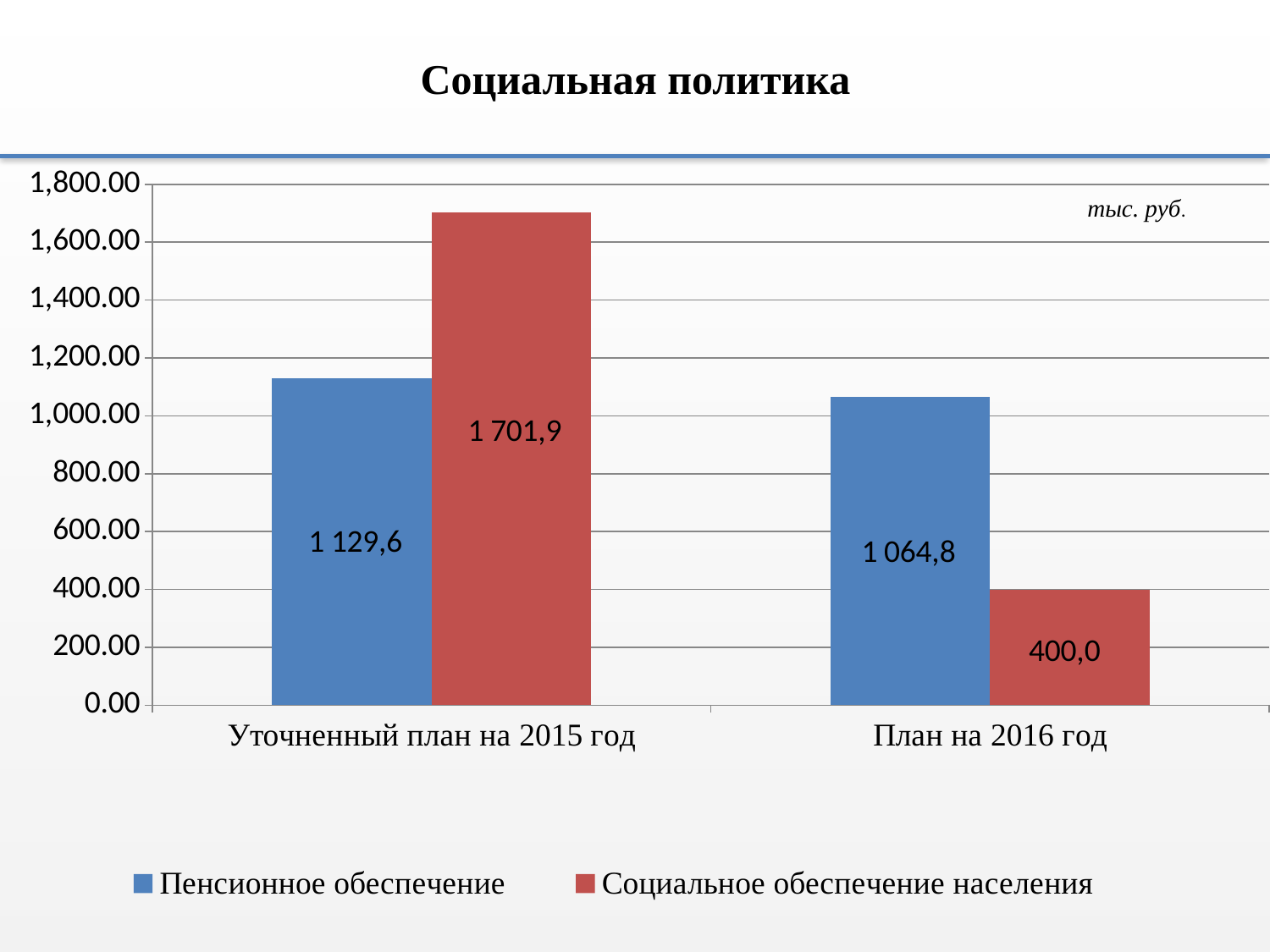
Which bar has the highest value on the chart? Социальное обеспечение населения, Уточненный план на 2015 год What unit is indicated on the chart? тыс. руб. What is the difference between Социальное обеспечение населения and Пенсионное обеспечение in Уточненный план на 2015 год? 572,3 What is the value for Социальное обеспечение населения in Уточненный план на 2015 год? 1 701,9 What is the value for Пенсионное обеспечение in Уточненный план на 2015 год? 1 129,6 What is the value for Пенсионное обеспечение in План на 2016 год? 1 064,8 How many series does the legend list? 2 Which is larger: Пенсионное обеспечение in Уточненный план на 2015 год or Пенсионное обеспечение in План на 2016 год? Уточненный план на 2015 год What is the value for Социальное обеспечение населения in План на 2016 год? 400,0 What is the difference between Пенсионное обеспечение and Социальное обеспечение населения in План на 2016 год? 664,8 What kind of chart is shown on the slide? Bar chart Which bar has the lowest value on the chart? Социальное обеспечение населения, План на 2016 год